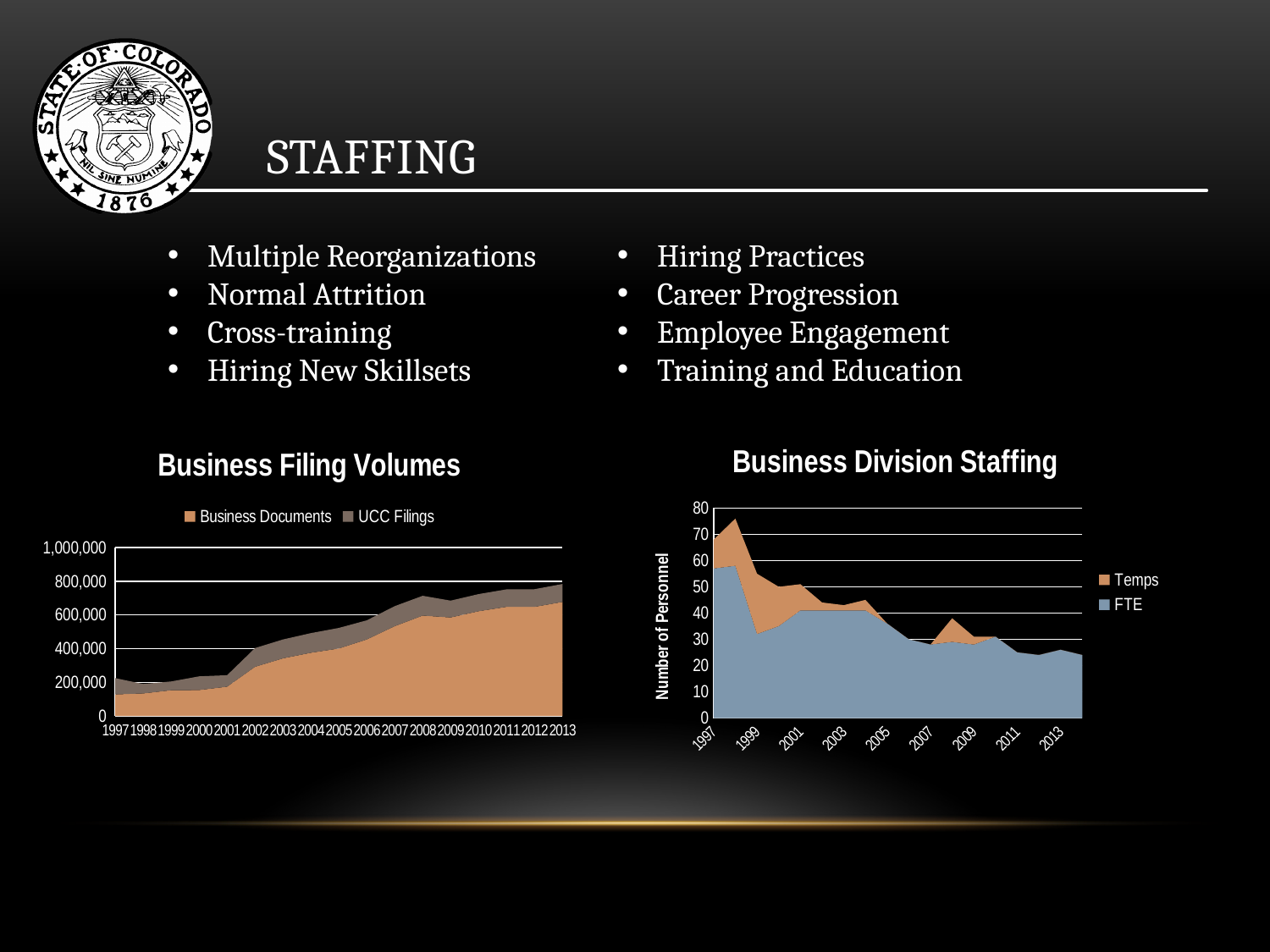
In the 'Business Division Staffing' chart, is the FTE value in 2013 greater or less than 30? less How many years are shown on the x axis of the 'Business Filing Volumes' chart? 17 In the 'Business Filing Volumes' chart, is the value for Business Documents in 2013 greater or less than 600,000? greater In the 'Business Filing Volumes' chart, do Business Documents generally rise or fall from 1997 to 2013? Rise What kind of chart is the 'Business Division Staffing' chart? Area chart In the 'Business Division Staffing' chart, is the FTE value in 1997 greater or less than 50? greater How many series does the legend of the 'Business Division Staffing' chart list? 2 In the 'Business Division Staffing' chart, does the FTE series generally rise or fall from 1997 to 2013? Fall How many series does the legend of the 'Business Filing Volumes' chart list? 2 What is the y-axis title of the 'Business Division Staffing' chart? Number of Personnel What kind of chart is the 'Business Filing Volumes' chart? Area chart